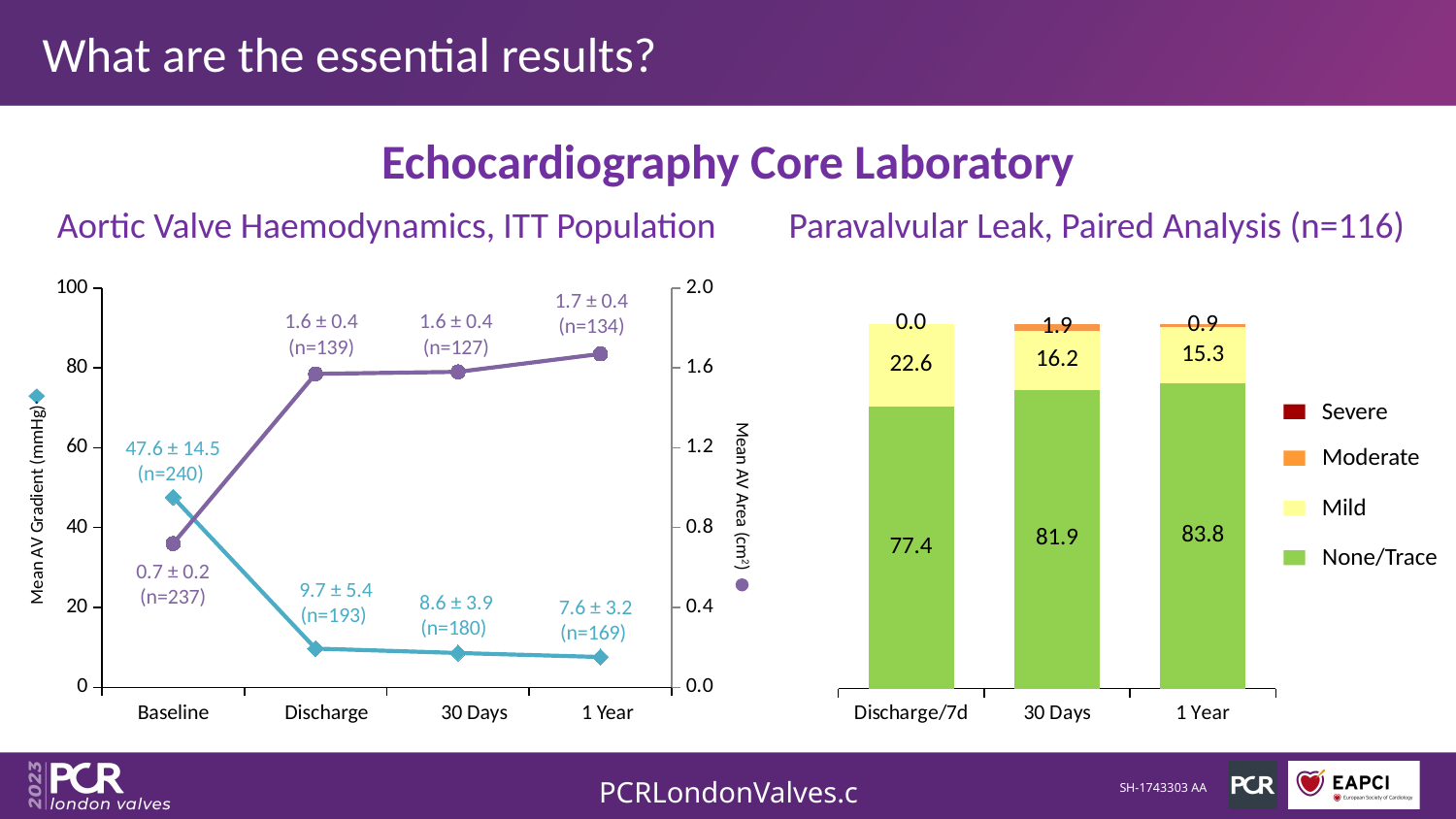
On the Paravalvular Leak chart, what is the Mild value at 30 Days? 16.2 On the Aortic Valve Haemodynamics chart, what is the Mean AV Gradient at Baseline? 47.6 ± 14.5 On the Paravalvular Leak chart, what is the None/Trace value at Discharge/7d? 77.4 On the Aortic Valve Haemodynamics chart, what is the Mean AV Gradient at Discharge? 9.7 ± 5.4 On the Aortic Valve Haemodynamics chart, how many time points are shown on the x axis? 4 On the Paravalvular Leak chart, what is the difference between the None/Trace values at 1 Year and Discharge/7d? 6.4 On the Paravalvular Leak chart, at which time point is the None/Trace value highest? 1 Year On the Paravalvular Leak chart, how many categories does the legend list? 4 On the Aortic Valve Haemodynamics chart, is the Mean AV Gradient at 30 Days greater or less than 20 mmHg? less On the Aortic Valve Haemodynamics chart, does the Mean AV Gradient rise or fall from Baseline to 1 Year? Fall What kind of chart is the Aortic Valve Haemodynamics chart? Line chart On the Aortic Valve Haemodynamics chart, what is the Mean AV Area at 1 Year? 1.7 ± 0.4